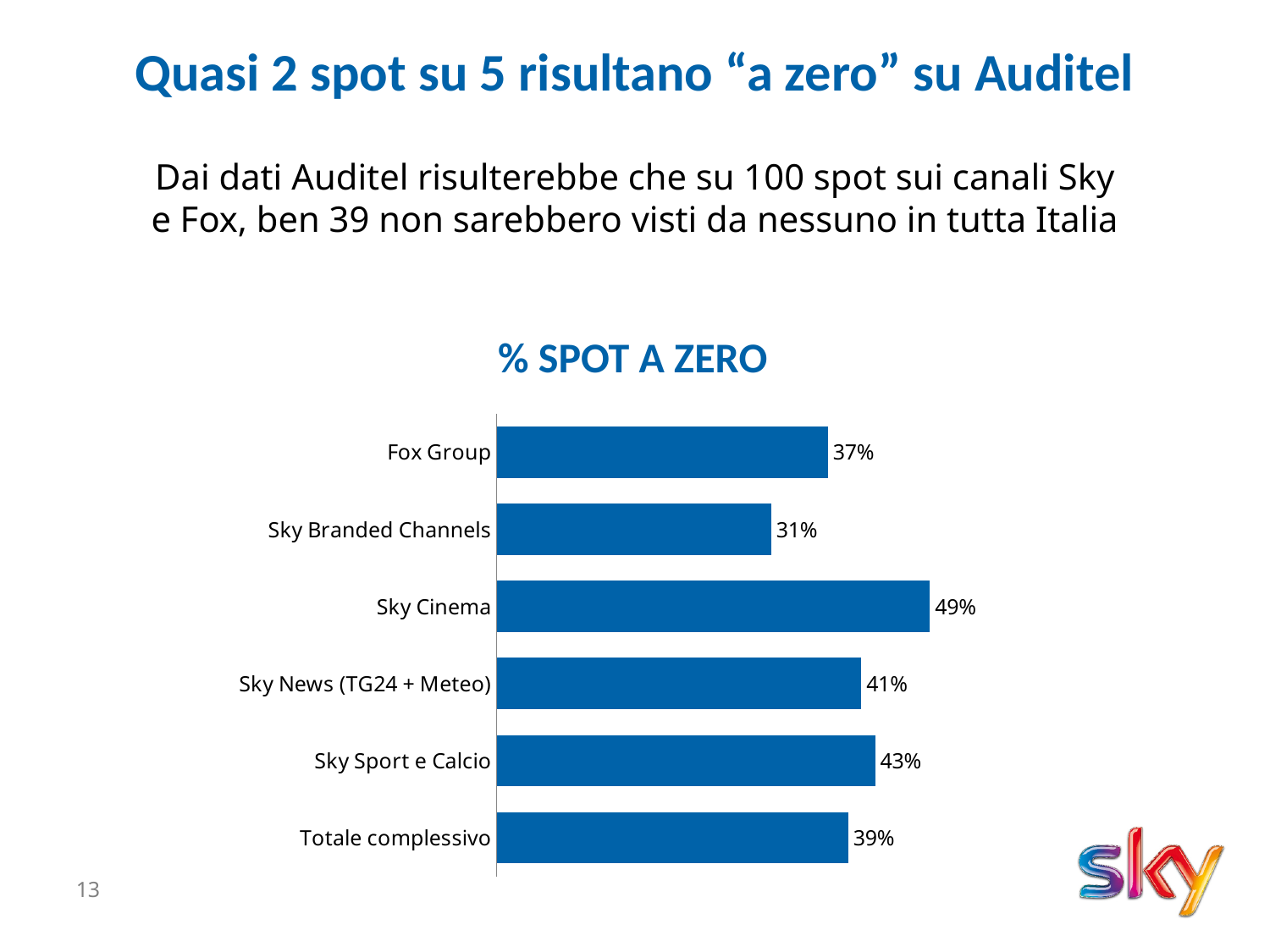
What is the value for Fox Group? 37% Which category has the highest value? Sky Cinema What is the value for Sky Cinema? 49% Which category has the lowest value? Sky Branded Channels What kind of chart is shown on the slide? Bar chart What is the difference between the values for Sky Cinema and Sky Branded Channels? 18% What is the value for Totale complessivo? 39% What is the value for Sky News (TG24 + Meteo)? 41% How many categories are shown in the chart? 6 Which is larger, the value for Sky Sport e Calcio or the value for Sky News (TG24 + Meteo)? Sky Sport e Calcio What is the title of the chart? % SPOT A ZERO What is the difference between the values for Sky Sport e Calcio and Fox Group? 6%